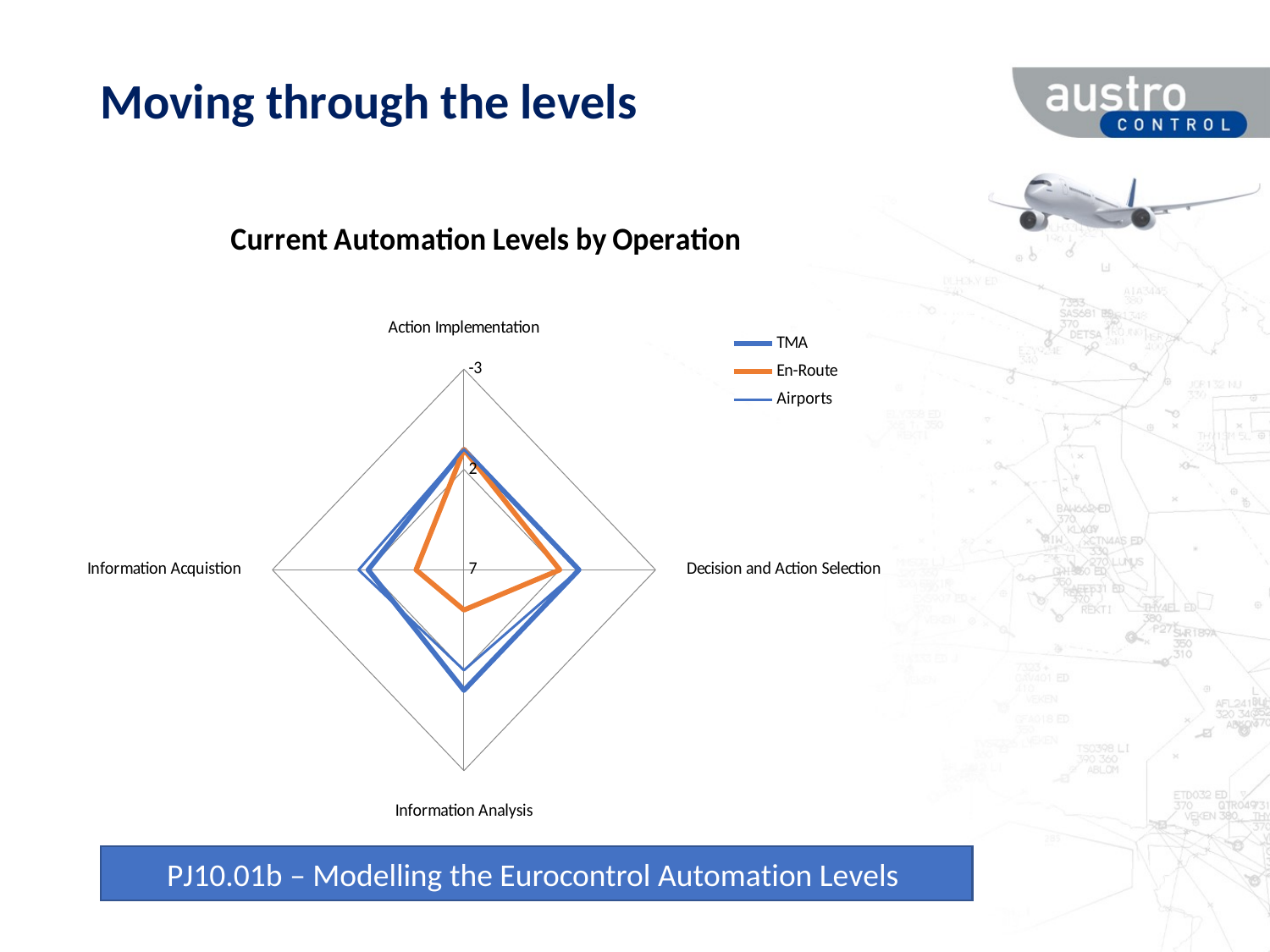
What kind of chart is shown on the slide? Radar chart On the Information Acquistion axis, which series' line lies closest to the centre of the radar chart, TMA or En-Route? En-Route How many series does the legend of the radar chart list? 3 Which series' line lies closest to the centre of the radar chart on the Information Analysis axis? En-Route Which series are listed in the legend of the radar chart? TMA, En-Route, Airports On the Information Analysis axis, which series' line lies closest to the centre of the radar chart, TMA or En-Route? En-Route What is the title of the radar chart? Current Automation Levels by Operation On the Decision and Action Selection axis, which series' line lies further from the centre of the radar chart, TMA or En-Route? TMA How many categories (axes) does the radar chart have? 4